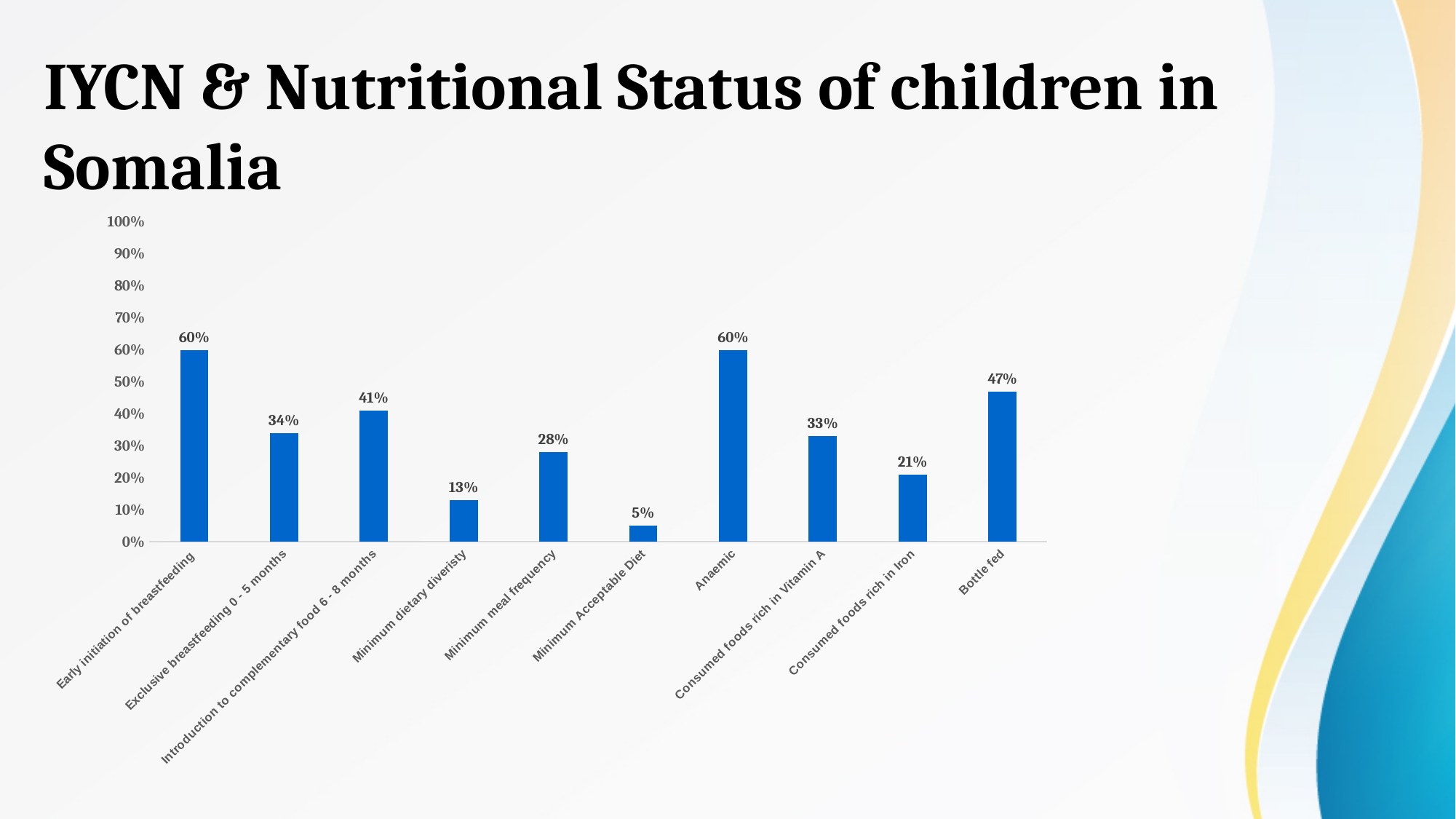
What is the difference between Introduction to complementary food 6 - 8 months and Exclusive breastfeeding 0 - 5 months? 7% How many categories are shown on the chart? 10 What is the value for Early initiation of breastfeeding? 60% What is the value for Minimum Acceptable Diet? 5% What is the title of the slide? IYCN & Nutritional Status of children in Somalia What kind of chart is shown on the slide? Bar chart What is the value for Bottle fed? 47% Is the value for Bottle fed greater or less than 40%? greater Which category has the lowest value? Minimum Acceptable Diet What is the difference between Anaemic and Consumed foods rich in Vitamin A? 27% Which is larger, Minimum meal frequency or Minimum dietary diveristy? Minimum meal frequency What is the value for Consumed foods rich in Iron? 21%